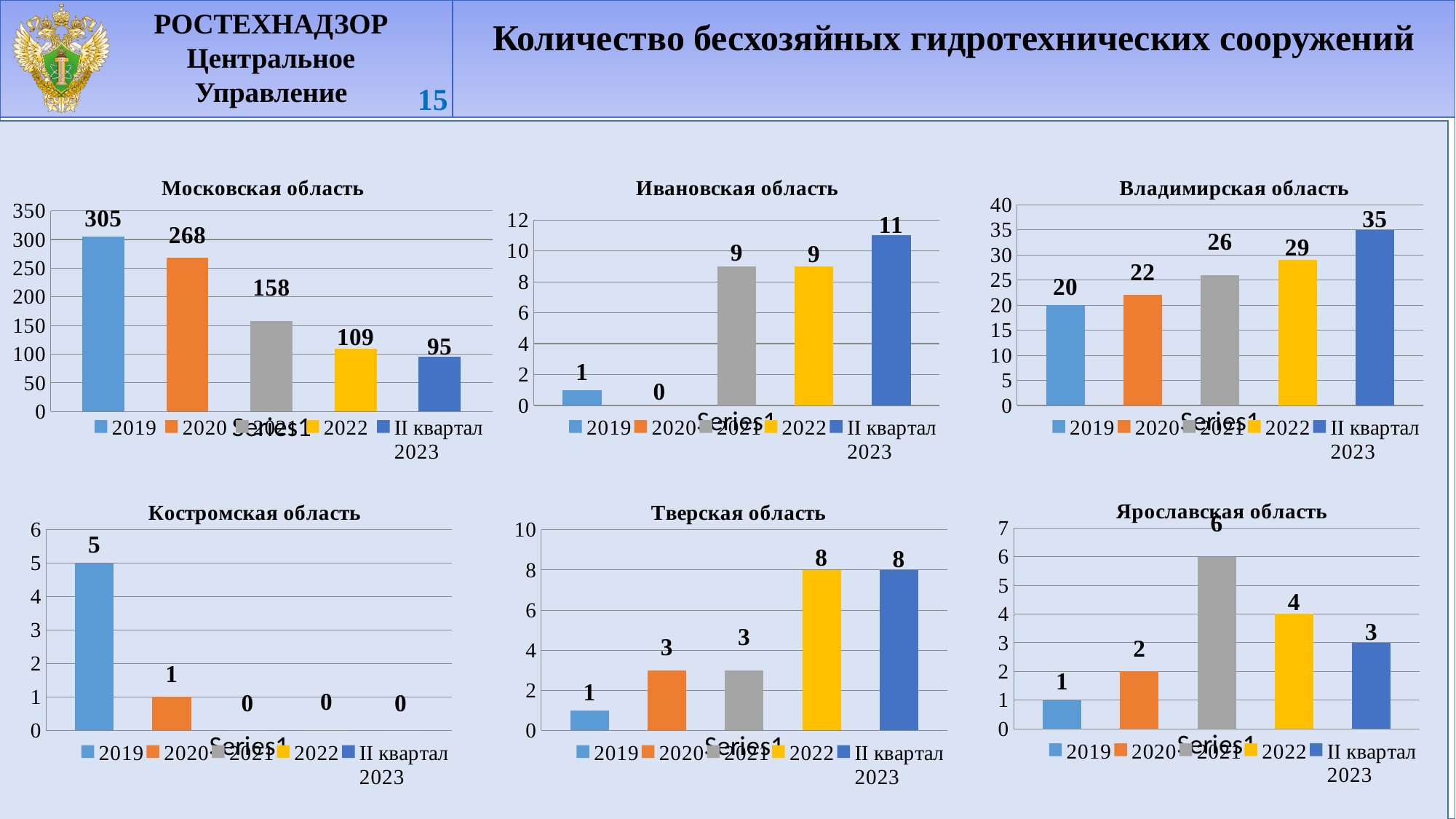
How many entries does the legend list in the chart titled "Ярославская область"? 5 In the chart titled "Московская область", do the values rise or fall from 2019 to II квартал 2023? fall In the chart titled "Московская область", what is the value for 2019? 305 In the chart titled "Костромская область", which legend entry has the highest value? 2019 In the chart titled "Ивановская область", what is the value for 2020? 0 In the chart titled "Ивановская область", which legend entry has the highest value? II квартал 2023 In the chart titled "Тверская область", which is larger, the value for 2020 or the value for 2022? 2022 In the chart titled "Владимирская область", do the values rise or fall from 2019 to II квартал 2023? rise In the chart titled "Московская область", what is the difference between the 2019 value and the 2020 value? 37 What kind of chart is the one titled "Тверская область"? bar chart In the chart titled "Ярославская область", what is the value for 2021? 6 In the chart titled "Владимирская область", what is the value for II квартал 2023? 35